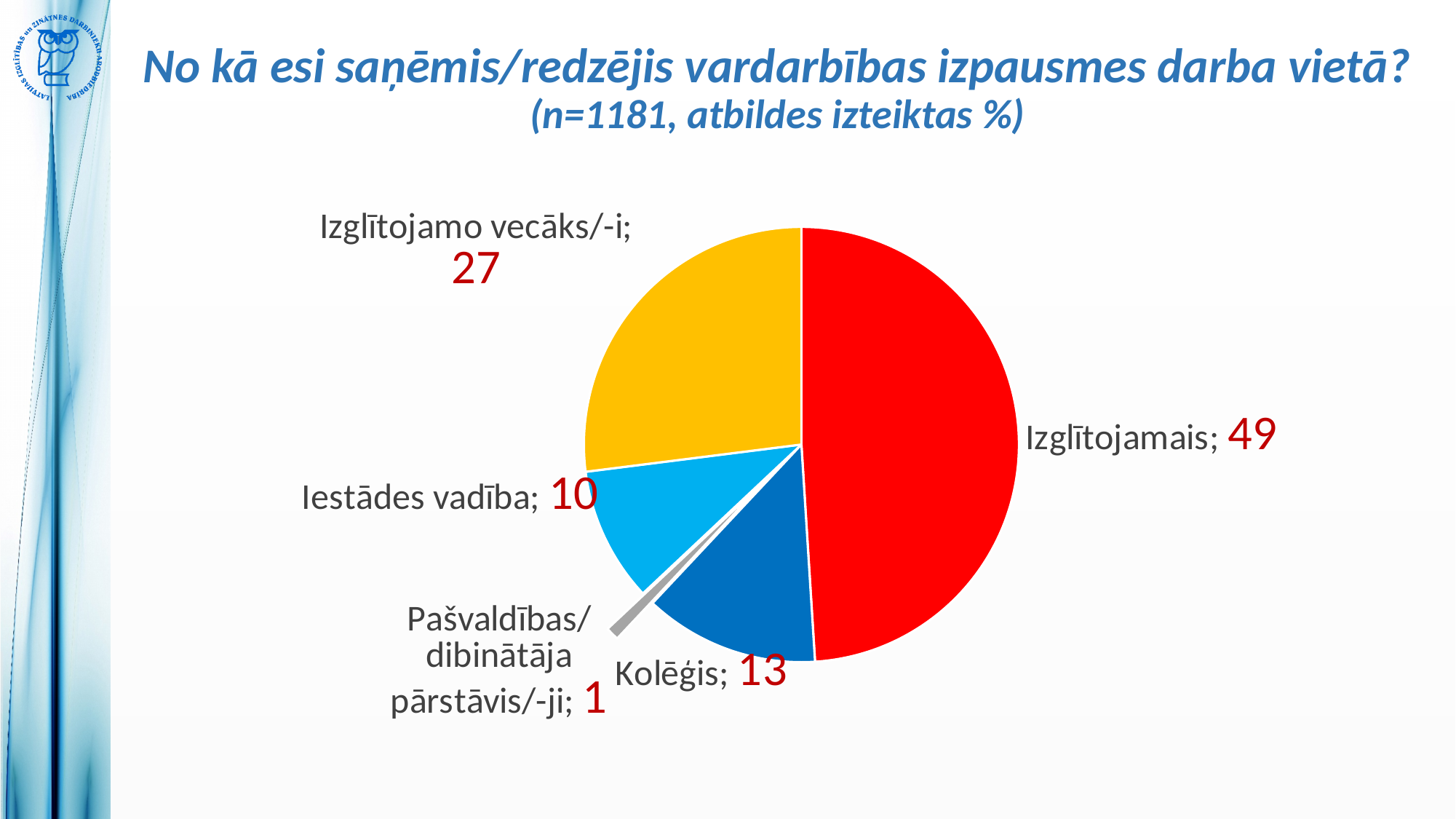
What is the difference between the values for Izglītojamais and Izglītojamo vecāks/-i? 22 What colour is the slice for Izglītojamo vecāks/-i? yellow What is the value for Izglītojamais? 49 What is the value for Pašvaldības/dibinātāja pārstāvis/-ji? 1 Which category has the largest slice? Izglītojamais Which category has the smallest slice? Pašvaldības/dibinātāja pārstāvis/-ji How many slices does the pie chart have? 5 Which is larger, the value for Kolēģis or the value for Iestādes vadība? Kolēģis What kind of chart is shown on the slide? pie chart What is the value for Iestādes vadība? 10 What is the value for Kolēģis? 13 What is the value for Izglītojamo vecāks/-i? 27